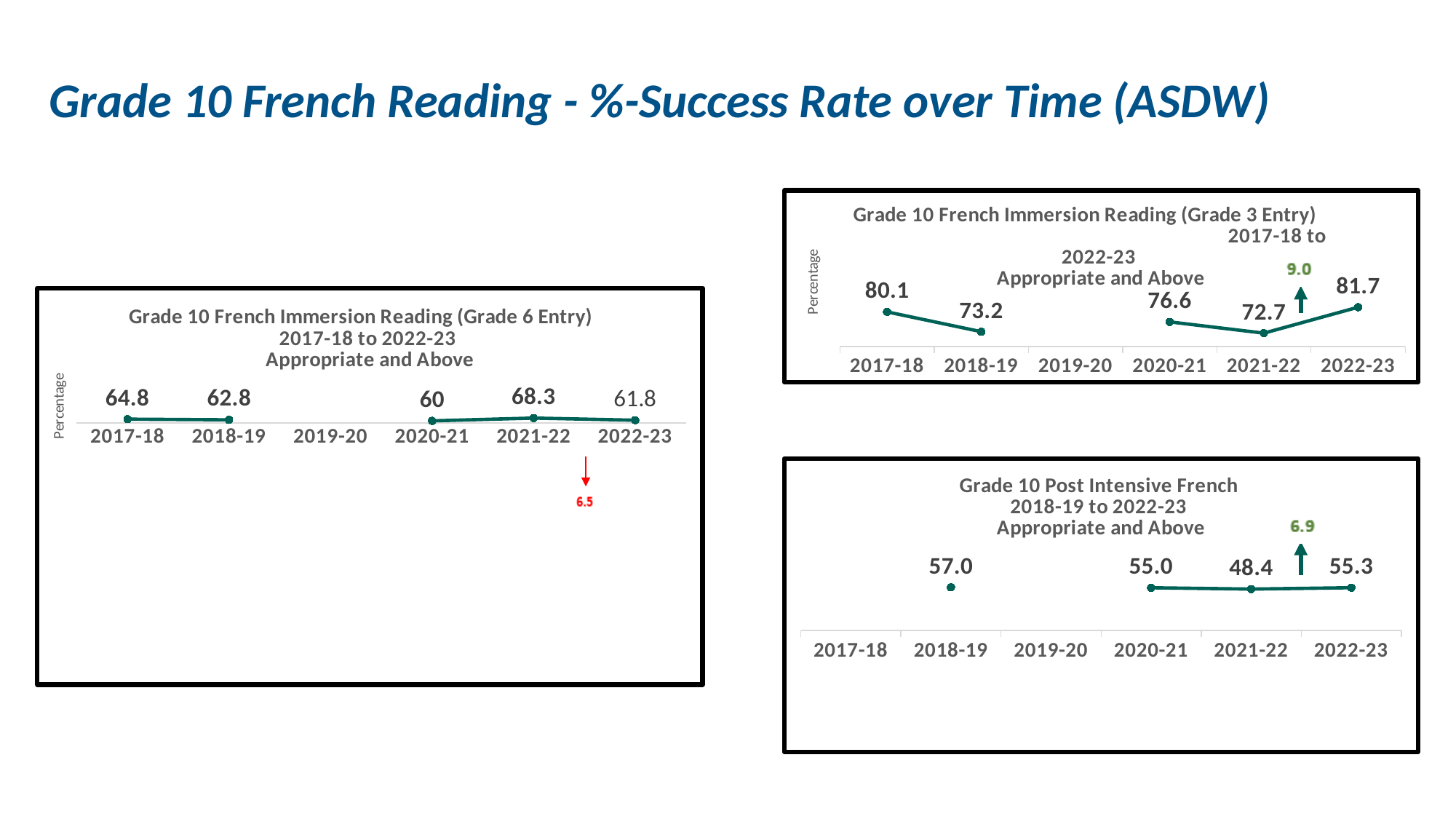
In the Grade 10 Post Intensive French chart, does the value rise or fall from 2021-22 to 2022-23? Rise In the Grade 10 French Immersion Reading (Grade 6 Entry) chart, what is the difference between the 2021-22 and 2022-23 values? 6.5 What kind of chart is the Grade 10 French Immersion Reading (Grade 6 Entry) chart? Line chart In the Grade 10 French Immersion Reading (Grade 3 Entry) chart, what is the difference between the 2021-22 and 2022-23 values? 9.0 In the Grade 10 French Immersion Reading (Grade 6 Entry) chart, which year has the lowest value? 2020-21 In the Grade 10 Post Intensive French chart, how many data points are plotted? 4 In the Grade 10 French Immersion Reading (Grade 3 Entry) chart, which year has the highest value? 2022-23 In the Grade 10 French Immersion Reading (Grade 3 Entry) chart, what is the value for 2022-23? 81.7 In the Grade 10 Post Intensive French chart, what is the value for 2021-22? 48.4 In the Grade 10 Post Intensive French chart, which year has the highest value? 2018-19 In the Grade 10 French Immersion Reading (Grade 6 Entry) chart, what is the value for 2021-22? 68.3 In the Grade 10 French Immersion Reading (Grade 3 Entry) chart, which is larger, the value for 2017-18 or 2018-19? 2017-18